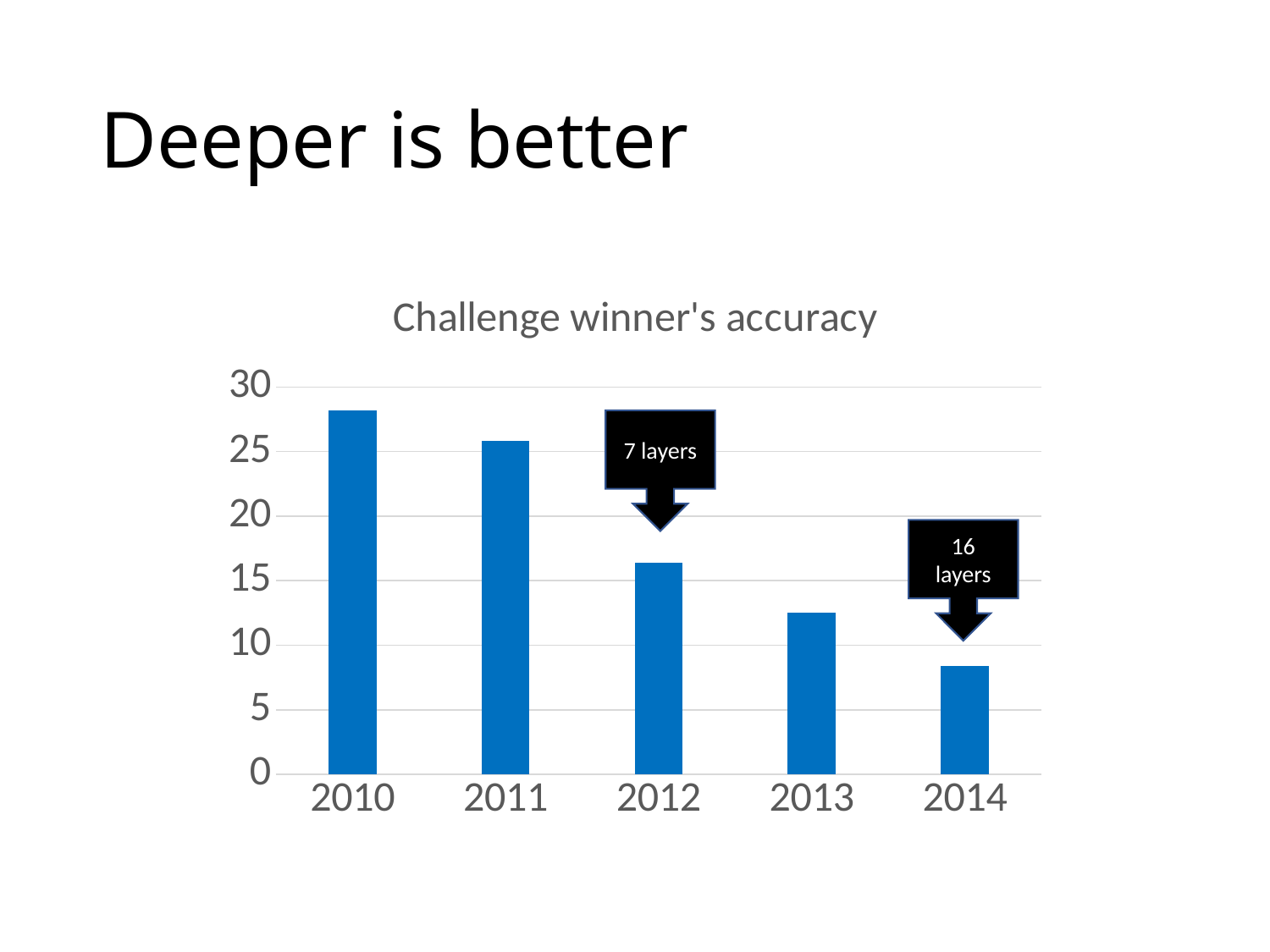
Do the values rise or fall from 2010 to 2014? fall Is the value for 2010 greater or less than 25? greater What is the title of the chart? Challenge winner's accuracy What kind of chart is shown on the slide? bar chart Is the value for 2014 greater or less than 10? less Which is larger, the value for 2011 or the value for 2013? 2011 Which year has the highest bar in the chart? 2010 How many years are shown on the x axis of the chart? 5 Is the value for 2012 greater or less than 20? less According to the annotation on the chart, how many layers are noted for the 2014 bar? 16 layers Which year has the lowest bar in the chart? 2014